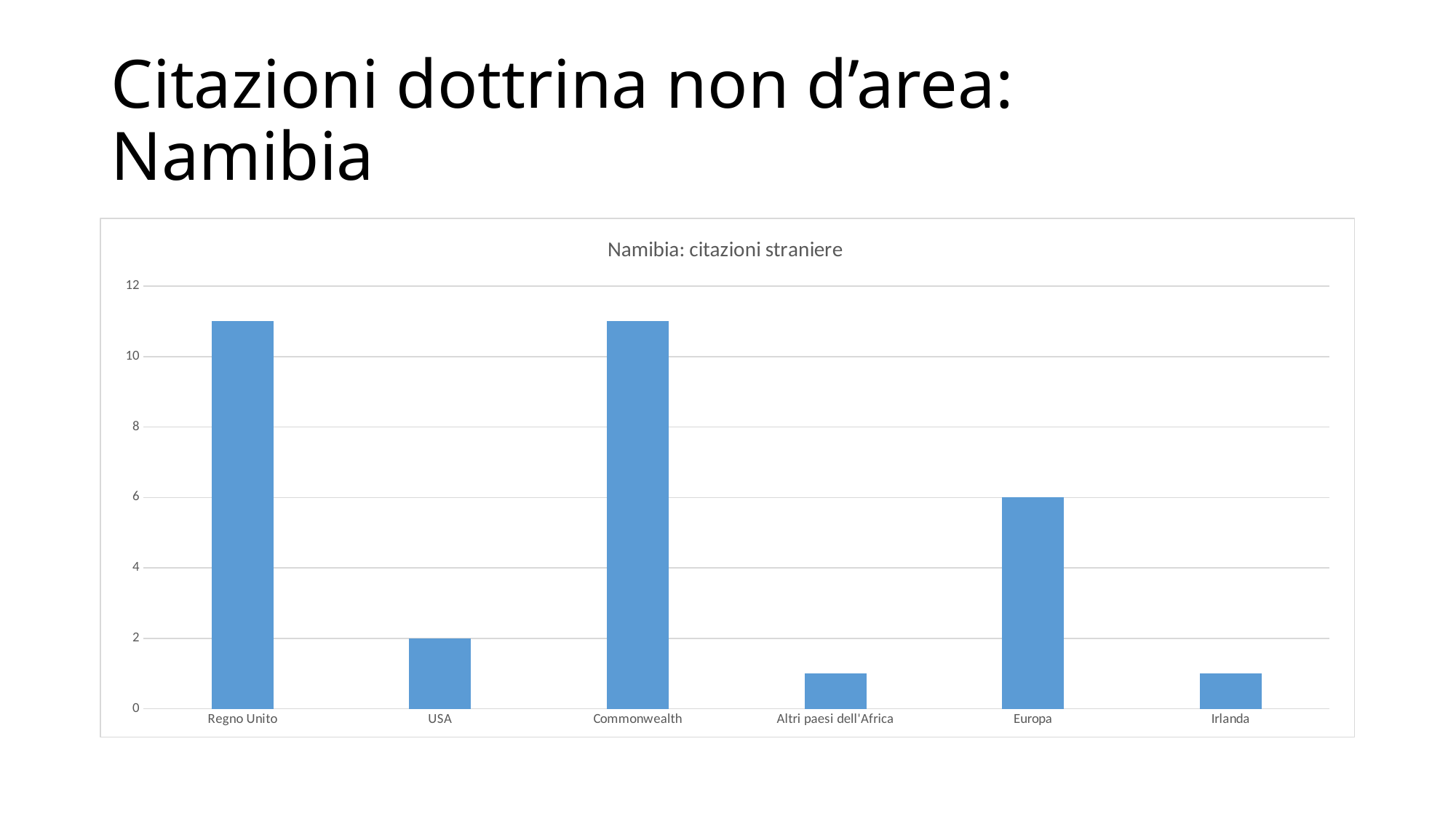
What is the value for USA? 2 What is the difference between the value for Europa and the value for USA? 4 How many categories are shown on the x axis of the chart? 6 Is the value for Altri paesi dell'Africa greater or less than 2? less Is the value for Irlanda greater or less than 2? less Which is larger, the value for Commonwealth or the value for Europa? Commonwealth Which is larger, the value for Europa or the value for USA? Europa What is the value for Europa? 6 Is the value for Regno Unito greater or less than 10? greater What type of chart is shown on the slide? bar chart What is the title of the chart? Namibia: citazioni straniere